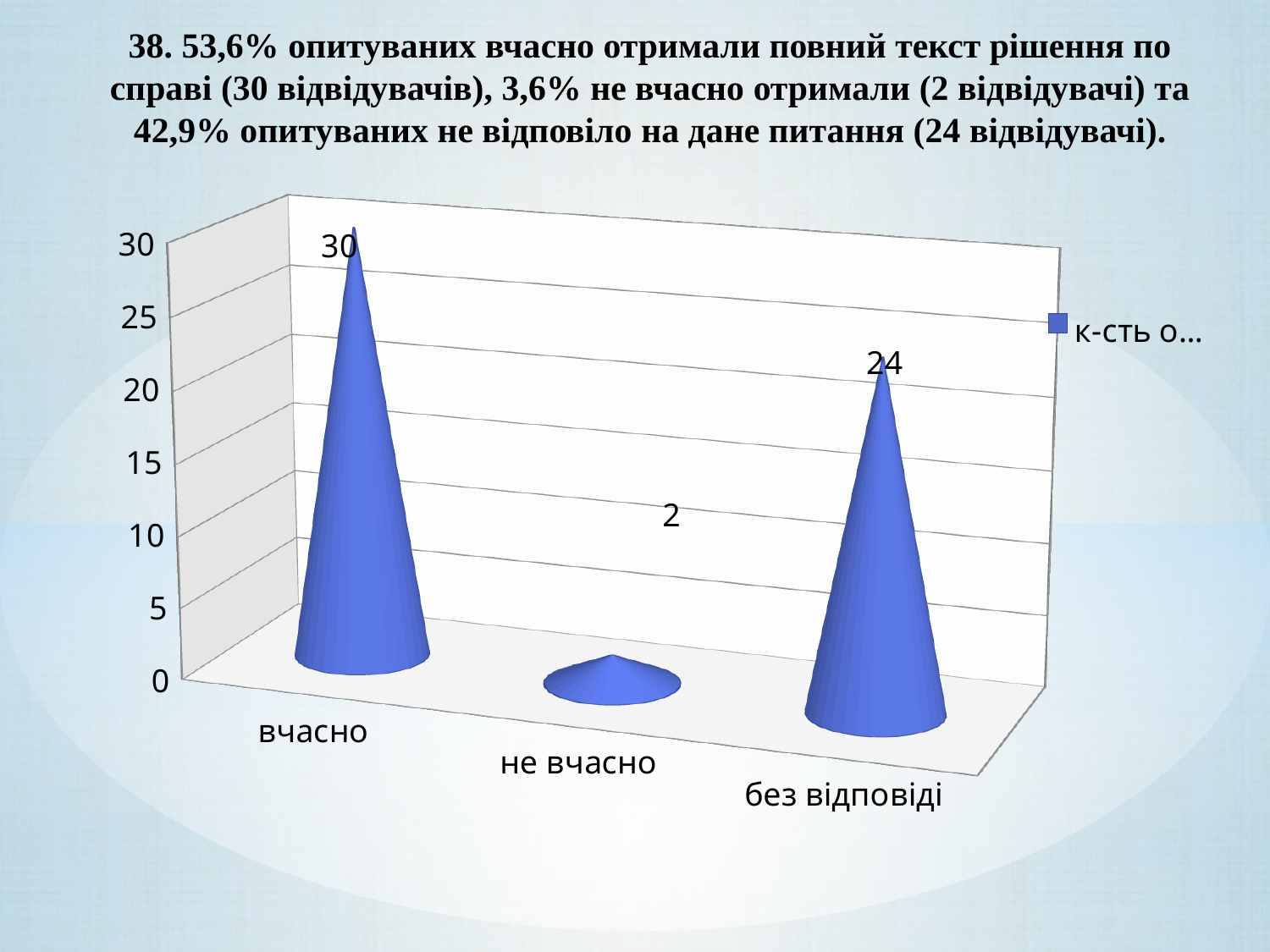
What is the value for the category "без відповіді"? 24 Which category has the highest value? вчасно Which category has the lowest value? не вчасно How many categories are shown on the x axis? 3 Which is larger, the value for "вчасно" or the value for "без відповіді"? вчасно How many series does the legend list? 1 What is the value for the category "не вчасно"? 2 What is the difference between the values for "без відповіді" and "не вчасно"? 22 What is the difference between the values for "вчасно" and "без відповіді"? 6 What kind of chart is shown on the slide? bar chart Is the value for "без відповіді" greater or less than 20? greater What is the value for the category "вчасно"? 30